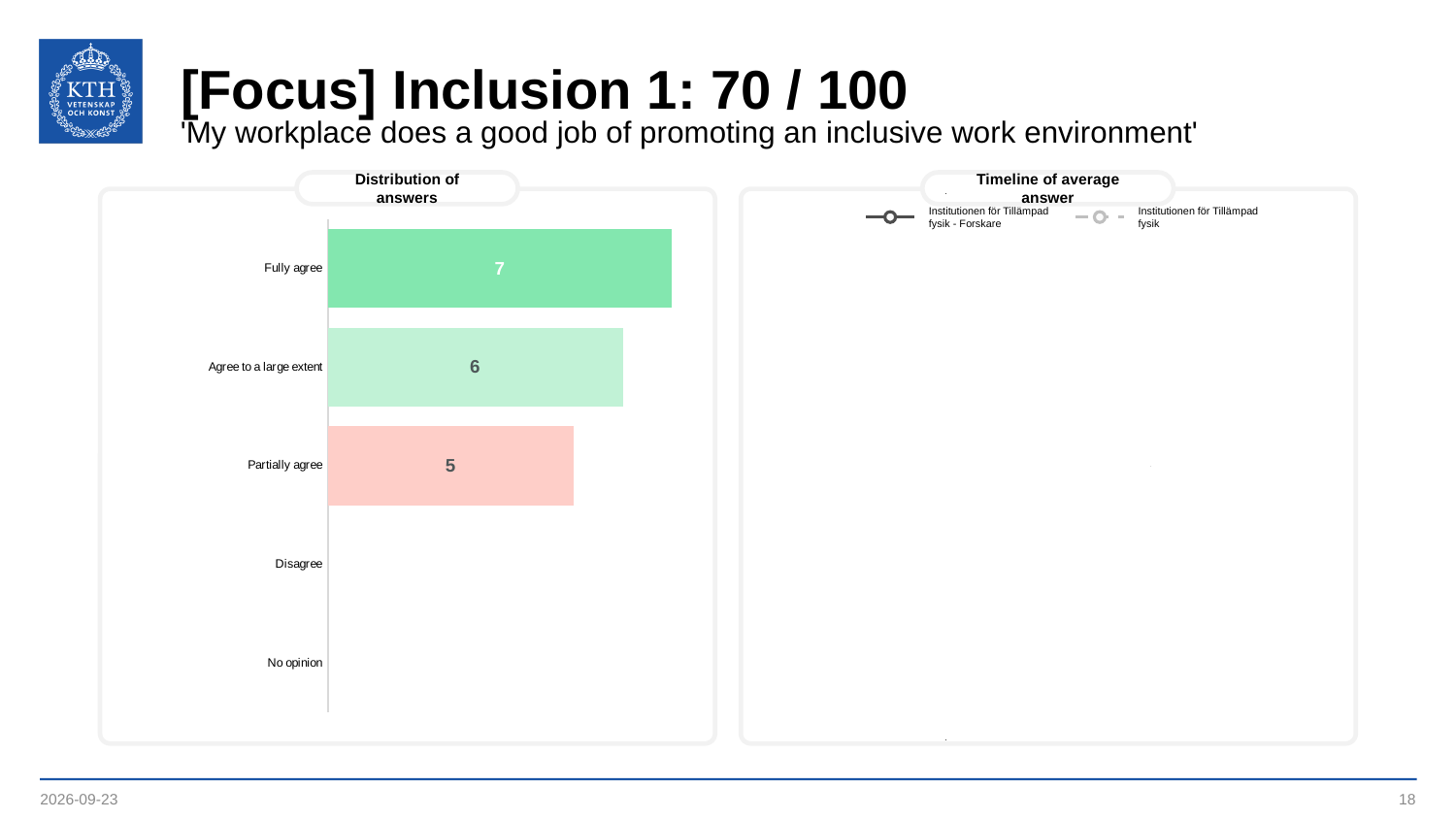
In the 'Distribution of answers' chart, which categories have no bar shown? Disagree and No opinion In the 'Distribution of answers' chart, what is the value for 'Agree to a large extent'? 6 In the 'Distribution of answers' chart, what is the value for 'Partially agree'? 5 In the 'Distribution of answers' chart, which category has the highest value? Fully agree In the 'Distribution of answers' chart, what is the difference between the values for 'Fully agree' and 'Partially agree'? 2 In the 'Distribution of answers' chart, how many categories are listed on the axis? 5 In the 'Distribution of answers' chart, what is the value for 'Fully agree'? 7 What kind of chart is the 'Distribution of answers' chart? Bar chart In the 'Distribution of answers' chart, what is the total of the values for 'Fully agree', 'Agree to a large extent' and 'Partially agree'? 18 What is the title of the chart on the right side of the slide? Timeline of average answer How many series does the legend of the 'Timeline of average answer' chart list? 2 In the 'Distribution of answers' chart, which is larger: the value for 'Agree to a large extent' or the value for 'Partially agree'? Agree to a large extent